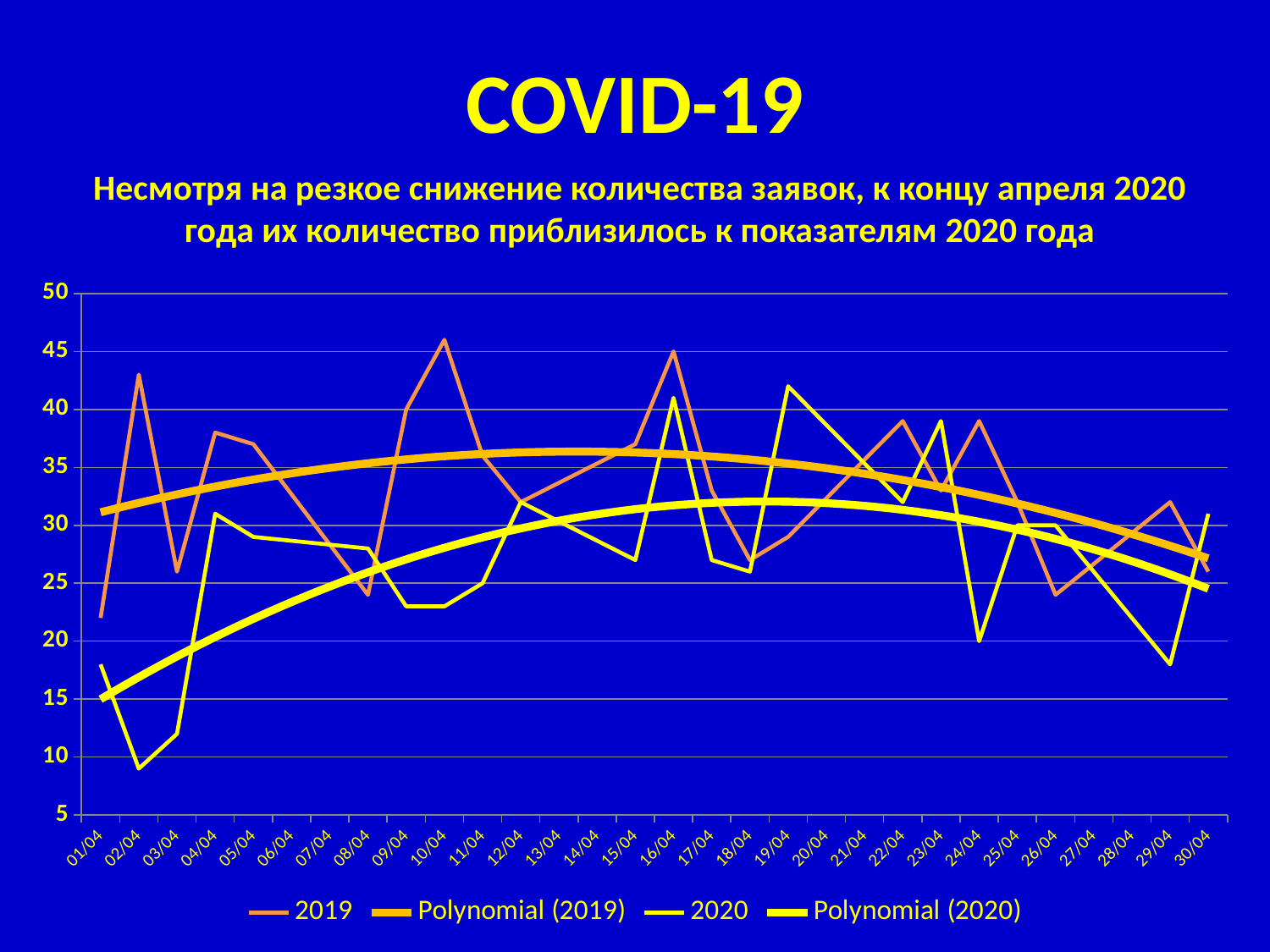
On which date does the 2020 series reach its lowest value? 02/04 Is the value for 2019 on 01/04 greater or less than 25? less What is the title of the slide containing the chart? COVID-19 On 19/04, which series has the larger value, 2019 or 2020? 2020 Is the value for 2020 on 19/04 greater or less than 40? greater How many dates are shown along the x axis? 30 How many series does the legend list? 4 Is the value for 2020 on 02/04 greater or less than 10? less Does the Polynomial (2019) trendline end higher or lower than it starts? lower What kind of chart is shown on the slide? line chart On 02/04, which series has the larger value, 2019 or 2020? 2019